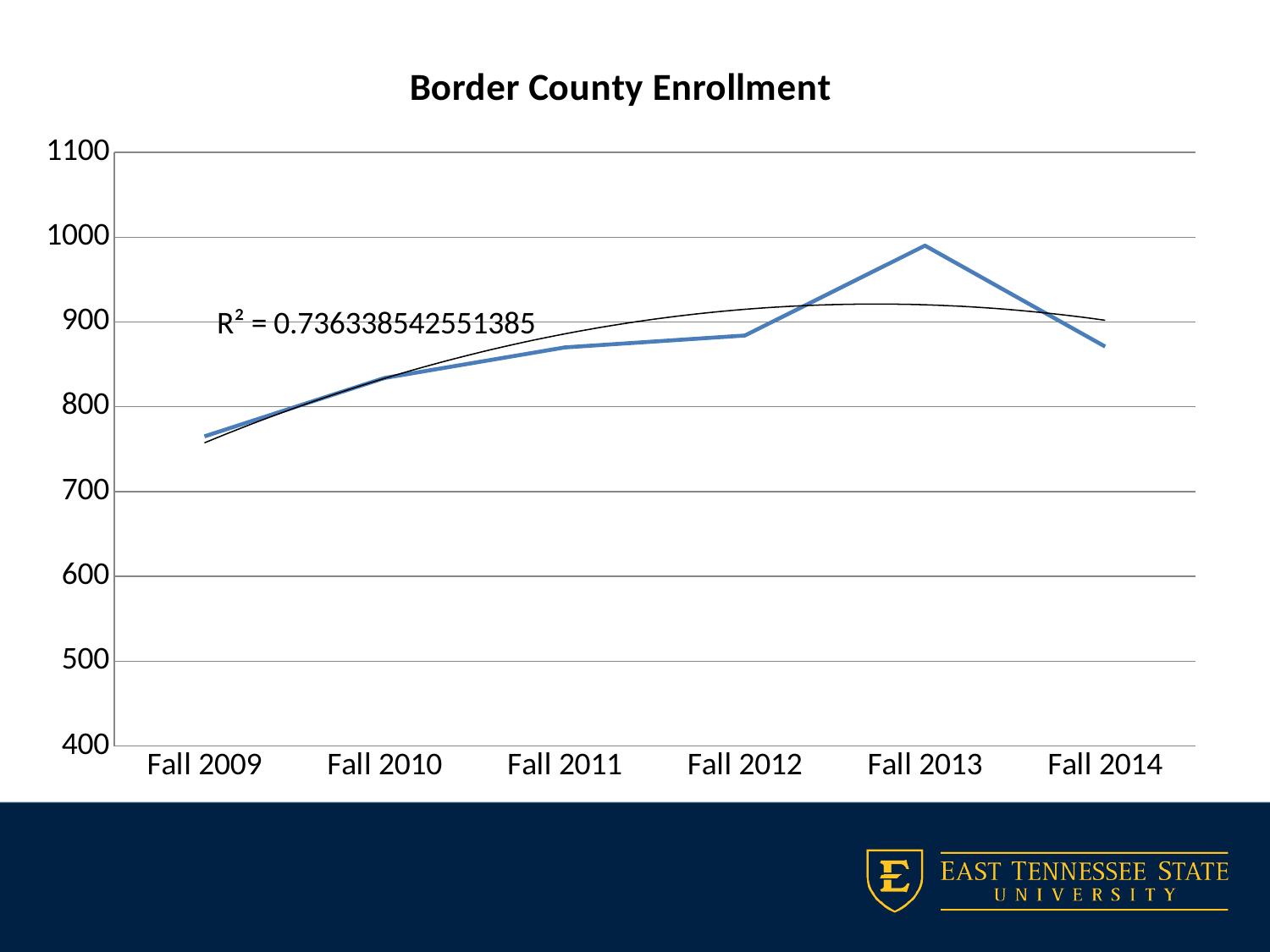
What is the title of the chart? Border County Enrollment How many time points are plotted along the x axis? 6 What kind of chart is shown on the slide? Line chart Is the value for Fall 2012 greater or less than 900? less Is the value for Fall 2010 greater or less than 800? greater Is the value for Fall 2009 greater or less than 800? less What R² value is printed on the chart for the trendline? 0.736338542551385 Which term has the highest enrollment? Fall 2013 Which term has the lowest enrollment? Fall 2009 Does enrollment rise or fall from Fall 2009 to Fall 2013? rise Which is larger, the enrollment for Fall 2013 or Fall 2014? Fall 2013